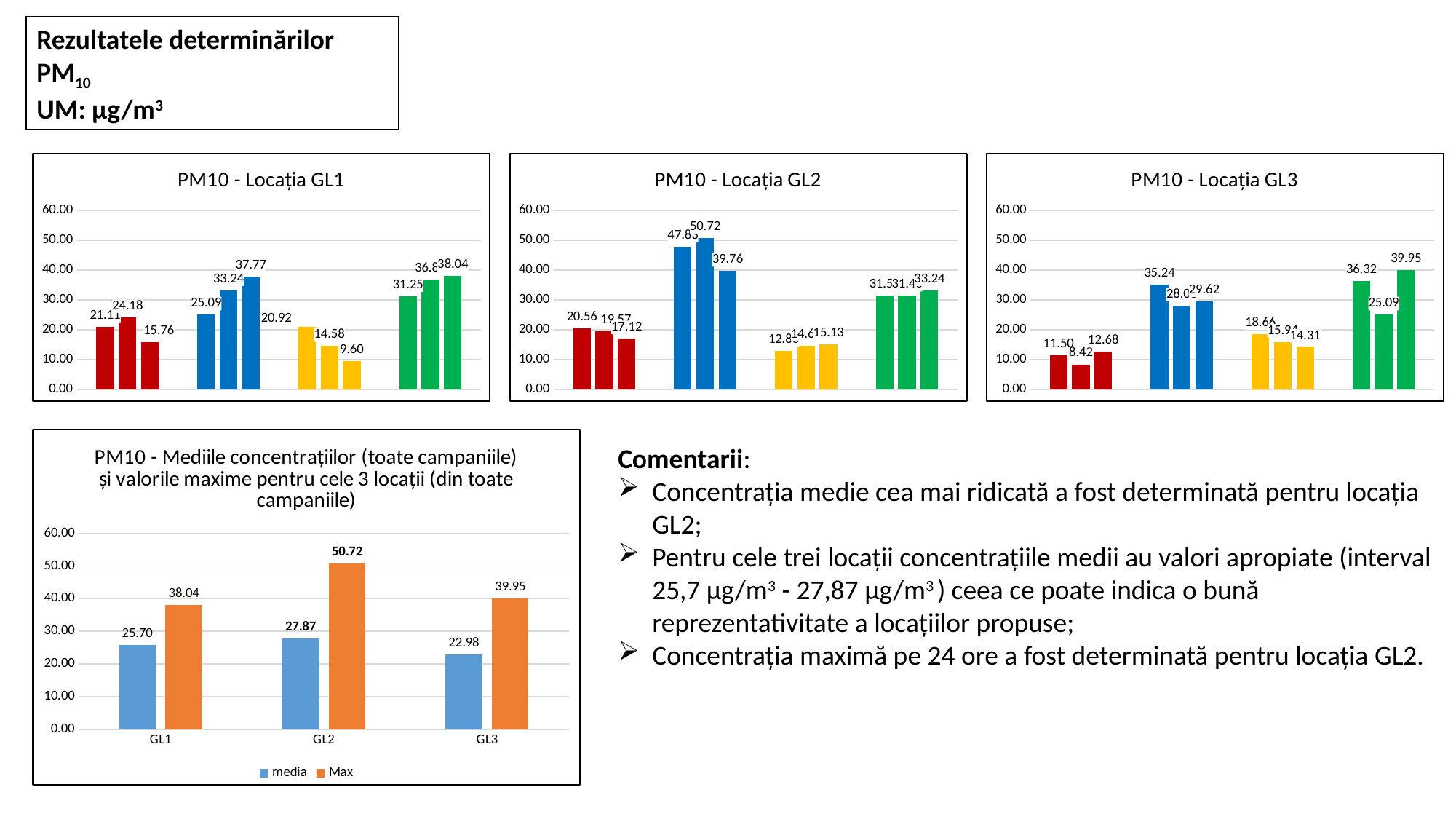
In the bottom-left chart, which is larger: the 'Max' value for GL1 or the 'Max' value for GL3? GL3 In the chart 'PM10 - Mediile concentrațiilor (toate campaniile) și valorile maxime pentru cele 3 locații', what is the 'Max' value for GL3? 39.95 In the chart 'PM10 - Locația GL3', what is the lowest labeled value? 8.42 In the bottom-left chart, what is the difference between the 'media' values for GL2 and GL1? 2.17 In the bottom-left chart, which location has the lowest 'media' value? GL3 In the chart 'PM10 - Locația GL2', what is the highest labeled value? 50.72 In the chart 'PM10 - Mediile concentrațiilor (toate campaniile) și valorile maxime pentru cele 3 locații', what is the 'media' value for GL2? 27.87 How many locations are shown on the x axis of the bottom-left chart? 3 What kind of chart is 'PM10 - Locația GL2'? bar chart In the bottom-left chart, which location has the highest 'Max' value? GL2 How many series does the legend of the bottom-left chart list? 2 In the bottom-left chart, what is the difference between the 'Max' and 'media' values for GL2? 22.85